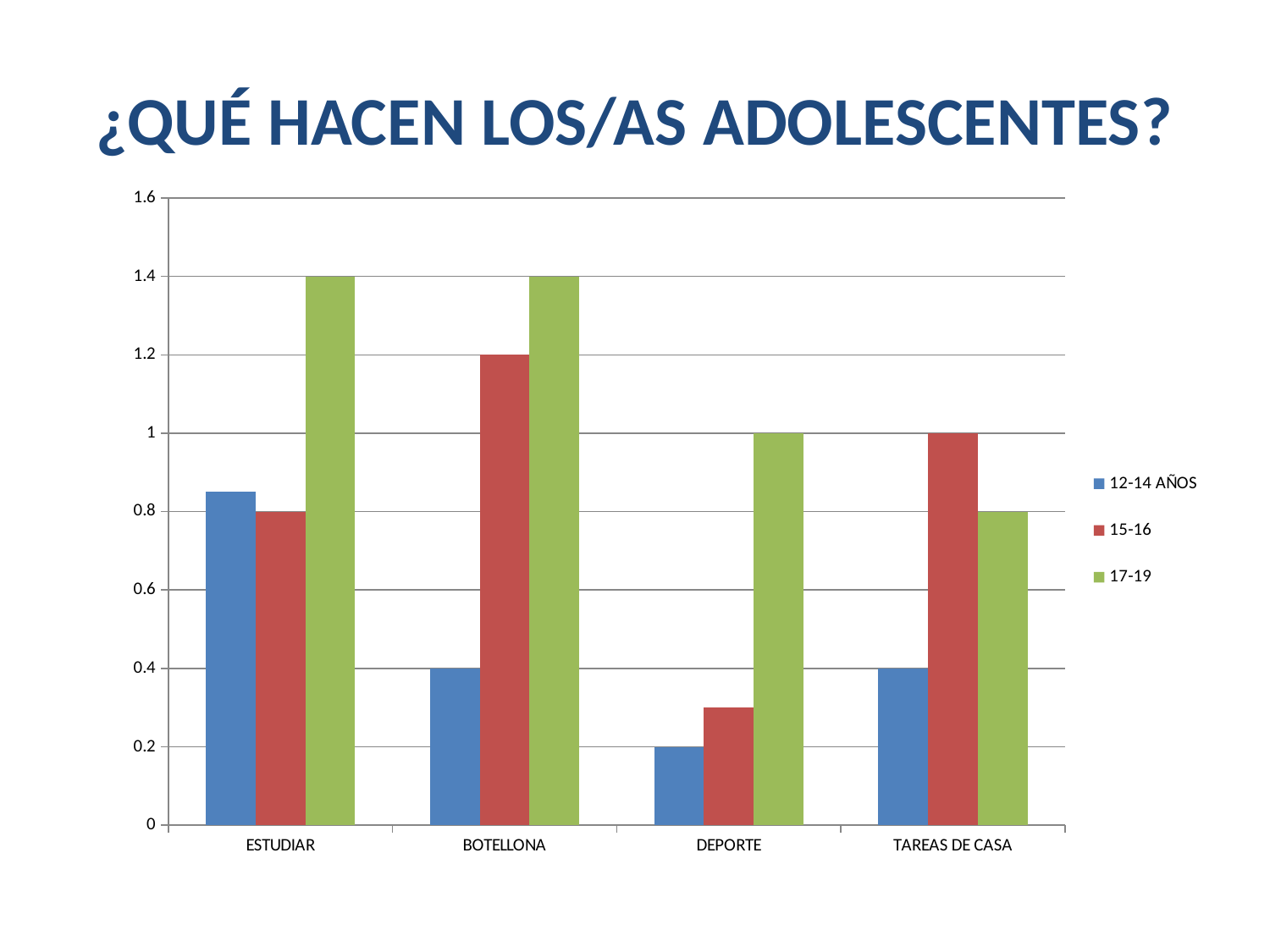
Which is larger in the TAREAS DE CASA category, the value for 15-16 or the value for 17-19? 15-16 How many categories are shown on the x axis? 4 Is the value for 12-14 AÑOS in the ESTUDIAR category greater or less than 0.8? greater What is the value for 17-19 in the ESTUDIAR category? 1.4 What is the value for 12-14 AÑOS in the DEPORTE category? 0.2 What is the value for 15-16 in the BOTELLONA category? 1.2 What is the value for 15-16 in the TAREAS DE CASA category? 1 What is the difference between the 17-19 value and the 12-14 AÑOS value in the BOTELLONA category? 1 Which category has the lowest value for the 12-14 AÑOS series? DEPORTE Which series has the highest value in the DEPORTE category? 17-19 What kind of chart is shown on the slide? bar chart How many series does the legend list? 3